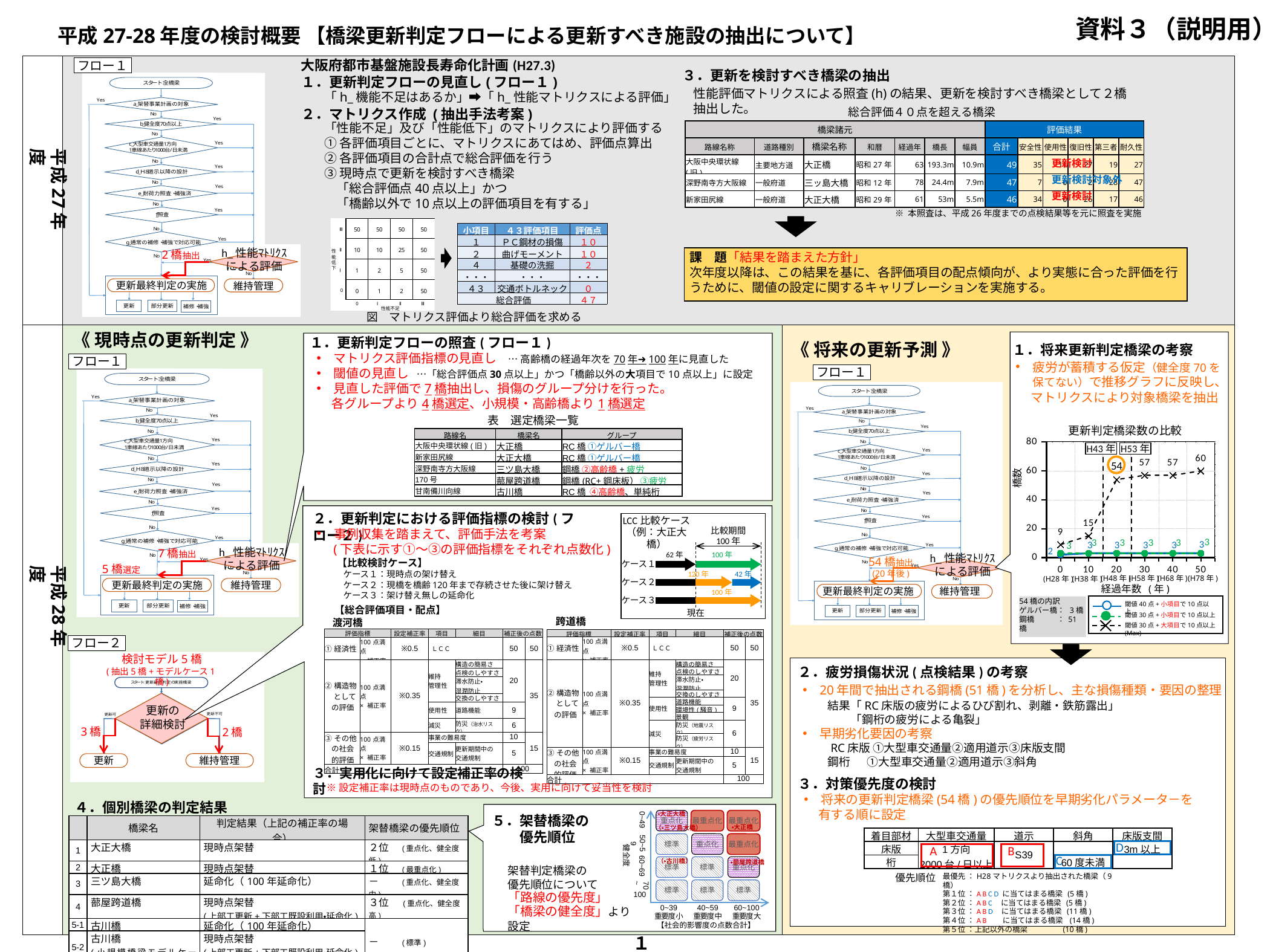
What kind of chart is 更新判定橋梁数の比較? line chart In 更新判定橋梁数の比較, what is the value of the 閾値30点+大項目で10点以上 (Max) series at 経過年数 0 years? 9 In 更新判定橋梁数の比較, at which 経過年数 is the 閾値30点+大項目で10点以上 (Max) series lowest? 0 How many 経過年数 points are plotted along the x axis of 更新判定橋梁数の比較? 6 In 更新判定橋梁数の比較, what is the value of the 閾値30点+大項目で10点以上 (Max) series at 経過年数 20 years? 54 How many series does the legend of 更新判定橋梁数の比較 list? 3 In 更新判定橋梁数の比較, what is the difference between the Max series values at 50 years and 20 years? 6 In 更新判定橋梁数の比較, what is the value of the 閾値30点+大項目で10点以上 (Max) series at 経過年数 10 years? 15 In 更新判定橋梁数の比較, what is the value of the 閾値30点+大項目で10点以上 (Max) series at 経過年数 50 years? 60 In 更新判定橋梁数の比較, which is larger for the Max series: the value at 20 years or at 10 years? 20 years In 更新判定橋梁数の比較, does the 閾値30点+大項目で10点以上 (Max) series rise or fall as 経過年数 increases? rise In 更新判定橋梁数の比較, at which 経過年数 does the 閾値30点+大項目で10点以上 (Max) series reach its highest value? 50